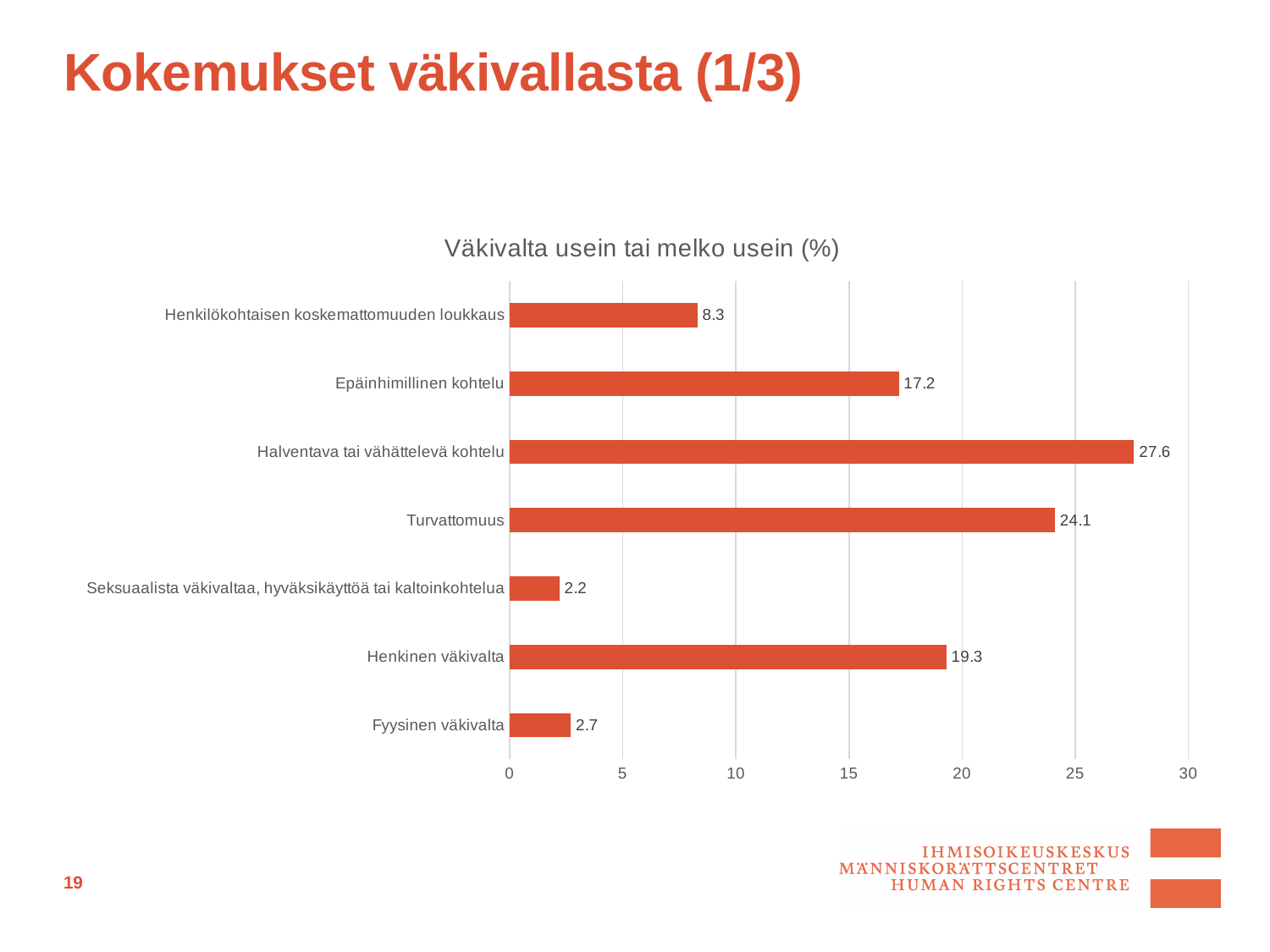
Which category has the lowest value? Seksuaalista väkivaltaa, hyväksikäyttöä tai kaltoinkohtelua What is the difference between the values for Epäinhimillinen kohtelu and Henkilökohtaisen koskemattomuuden loukkaus? 8.9 What is the difference between the values for Halventava tai vähättelevä kohtelu and Turvattomuus? 3.5 What is the value for Henkinen väkivalta? 19.3 Which category has the highest value? Halventava tai vähättelevä kohtelu Which is larger, the value for Henkinen väkivalta or the value for Epäinhimillinen kohtelu? Henkinen väkivalta Is the value for Fyysinen väkivalta greater or less than 5? less How many categories are shown in the chart? 7 What is the title of the chart? Väkivalta usein tai melko usein (%) What is the value for Turvattomuus? 24.1 What is the value for Seksuaalista väkivaltaa, hyväksikäyttöä tai kaltoinkohtelua? 2.2 What kind of chart is shown on the slide? bar chart